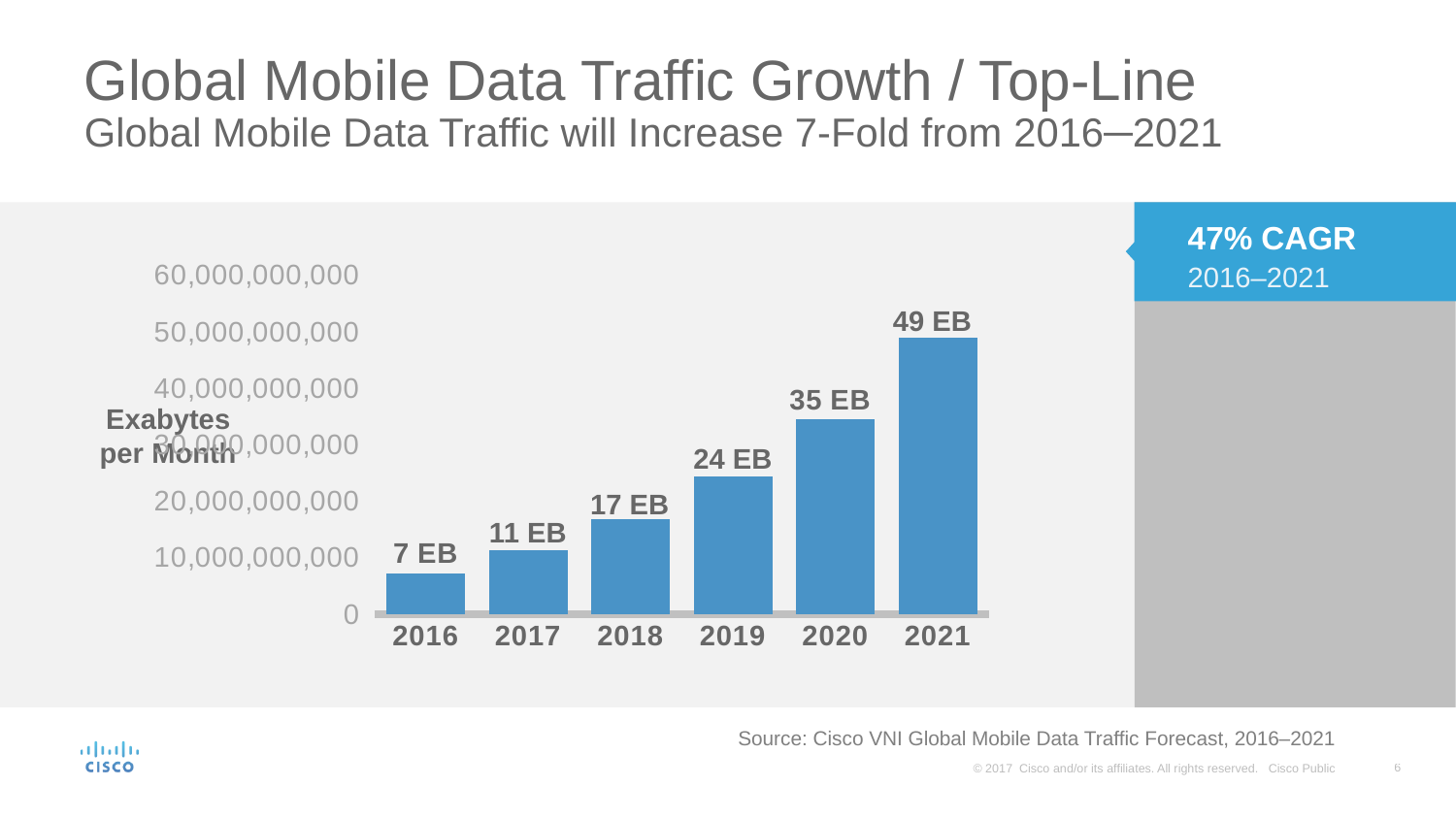
What is the value for 2021? 49 EB What CAGR for 2016–2021 is stated on the slide? 47% CAGR How many years are shown on the x axis? 6 What is the value for 2019? 24 EB Which is larger, the value for 2018 or the value for 2020? 2020 What is the difference between the values for 2021 and 2016? 42 EB What is the difference between the values for 2020 and 2018? 18 EB Do the values rise or fall from 2016 to 2021? Rise Which year has the highest value? 2021 Which year has the lowest value? 2016 What is the value for 2016? 7 EB What kind of chart is shown? Bar chart